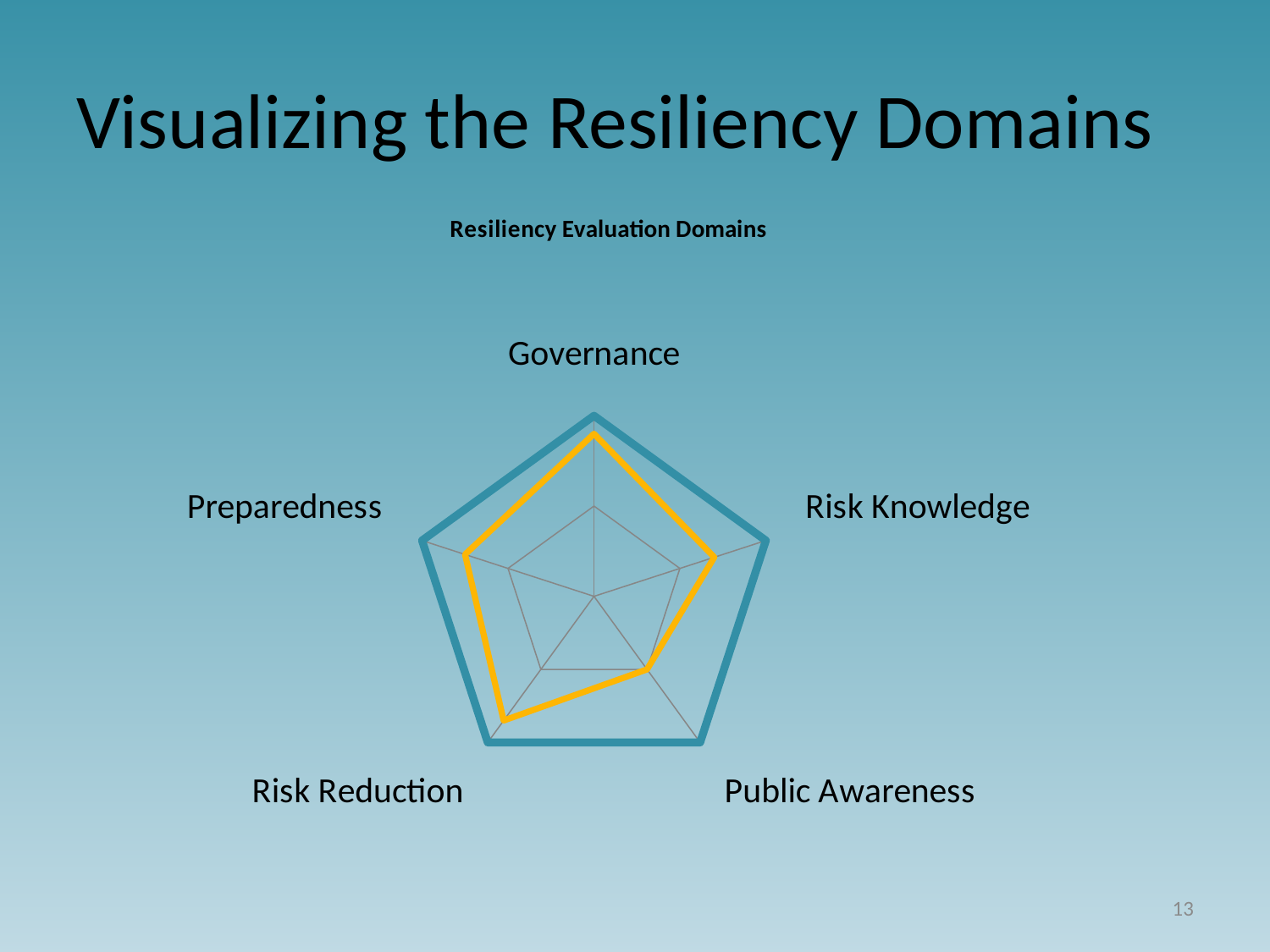
What kind of chart is shown on the slide? Radar chart Which domain is plotted at the bottom-left vertex of the radar chart? Risk Reduction How many categories (domains) are plotted on the radar chart? 5 Which domain is plotted at the right vertex of the radar chart? Risk Knowledge Which domain is plotted at the top vertex of the radar chart? Governance On the yellow line, which is larger: the value for Governance or the value for Public Awareness? Governance On the yellow line, which is larger: the value for Risk Reduction or the value for Public Awareness? Risk Reduction Which domain has the lowest value on the yellow line of the radar chart? Public Awareness What is the title of the chart? Resiliency Evaluation Domains